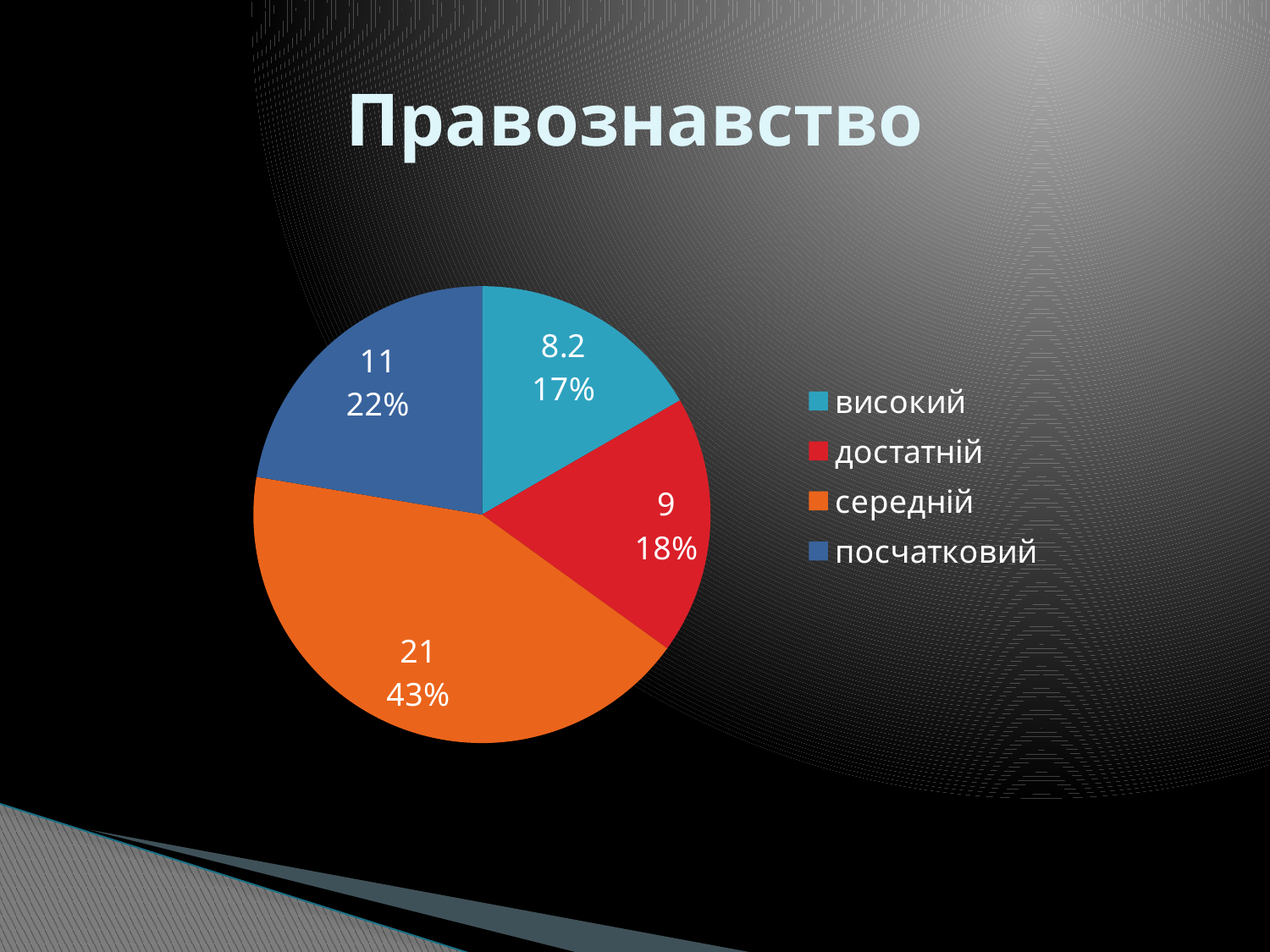
What is the title of the chart? Правознавство What percentage share does достатній have? 18% Which category has the largest slice? середній What is the value for високий? 8.2 What kind of chart is shown on the slide? pie chart What percentage share does середній have? 43% What is the difference between the values for середній and посчатковий? 10 Which is larger, the value for достатній or the value for посчатковий? посчатковий How many categories does the legend list? 4 What is the value for посчатковий? 11 Which category has the smallest slice? високий What is the value for середній? 21